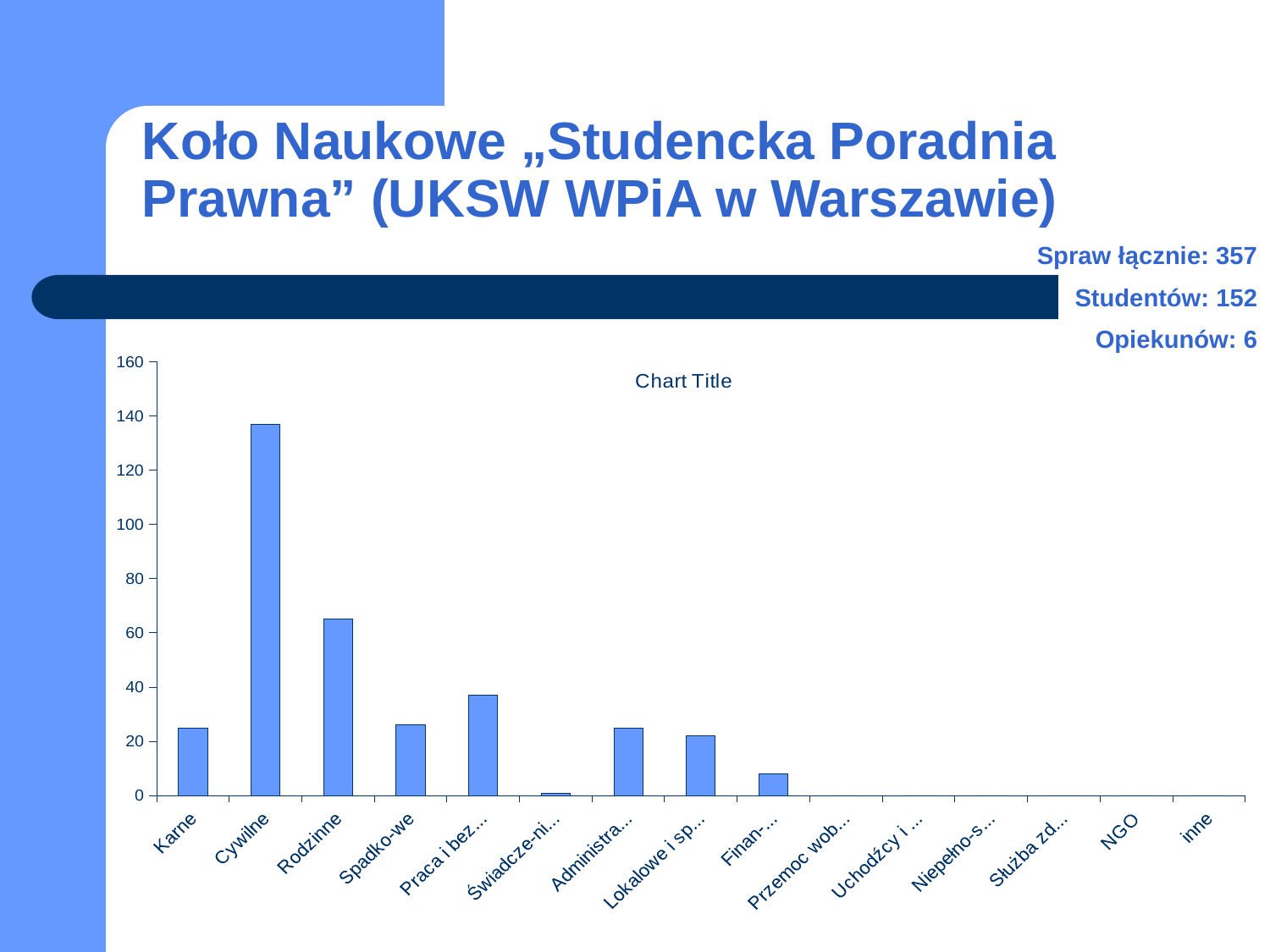
How many categories are shown on the x axis of the chart? 15 Which category has the highest bar in the chart? Cywilne Which is larger, the value for Praca i bez... or the value for Spadko-we? Praca i bez... Is the value for Cywilne greater or less than 120? greater Which is larger, the value for Cywilne or the value for Rodzinne? Cywilne Is the value for Karne greater or less than 20? greater What is the title shown on the chart? Chart Title Is the value for Finan-... greater or less than 20? less What kind of chart is shown on the slide? bar chart Which is larger, the value for Rodzinne or the value for Karne? Rodzinne